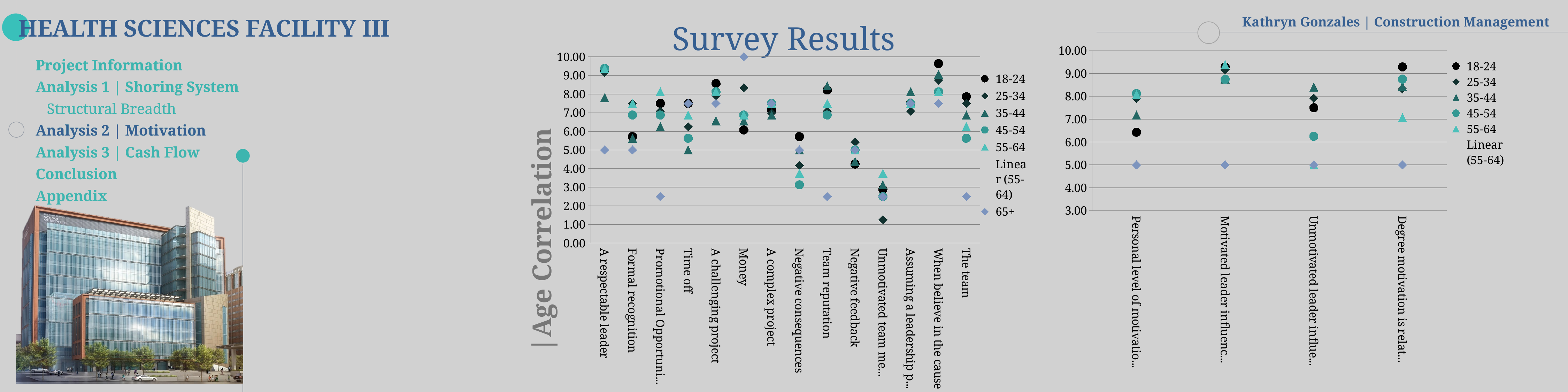
What kind of chart is the Survey Results chart on the left? scatter chart In the Survey Results chart on the left, how many entries does the legend list? 7 What is the title of the chart on the left? Survey Results In the Survey Results chart on the left, is the 65+ value for Promotional Opportuni... greater or less than 3.00? less In the chart on the right, is the 18-24 value for Personal level of motivatio... greater or less than 7.00? less In the chart on the right, is the 45-54 value for Unmotivated leader influe... greater or less than 7.00? less In the Survey Results chart on the left, how many categories are shown along the x axis? 14 In the chart on the right, how many categories are shown along the x axis? 4 In the chart on the right, how many entries does the legend list? 6